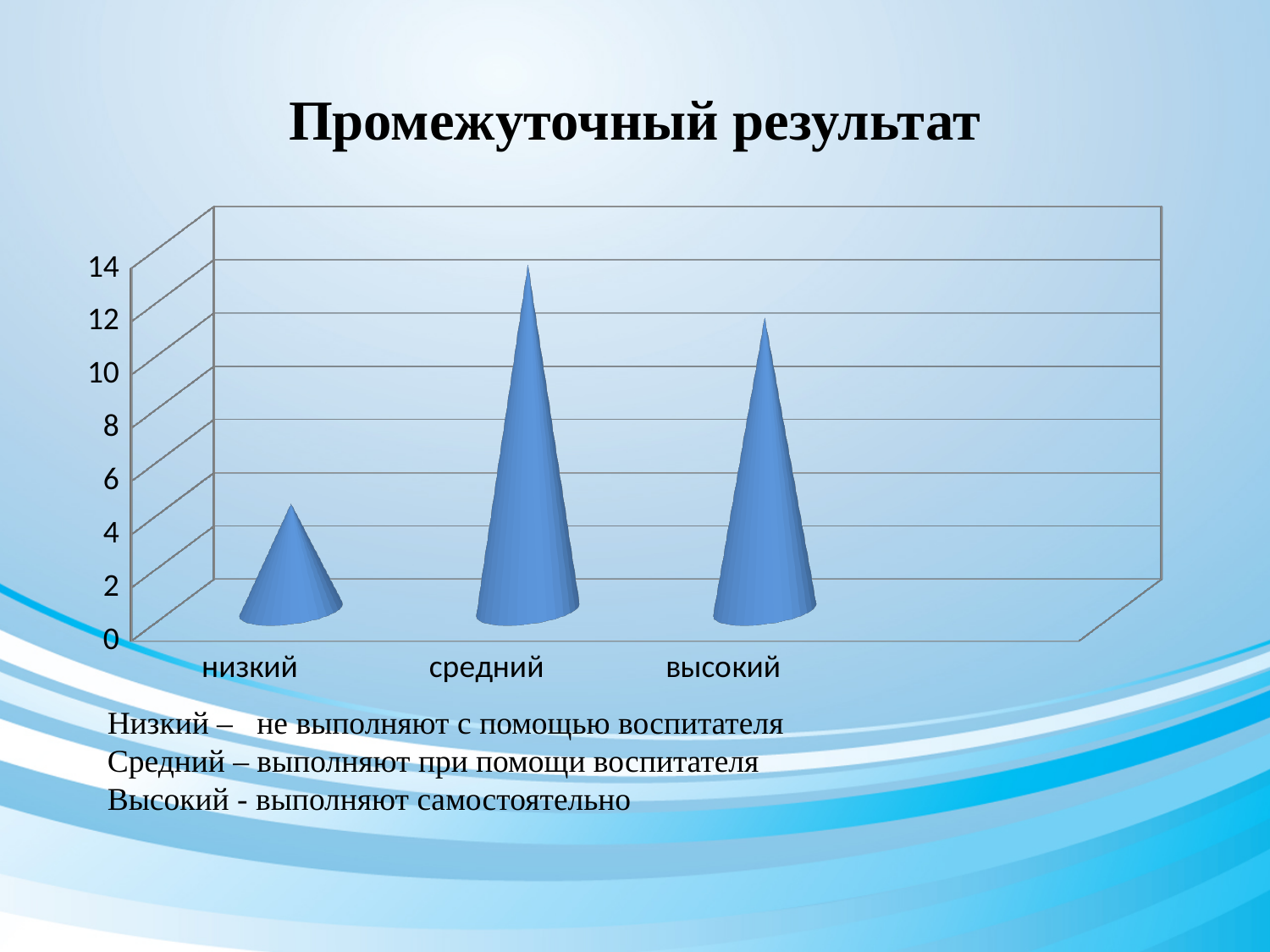
How many categories are shown on the x axis? 3 Is the value for высокий greater or less than 8? greater Which category has the lowest value? низкий Is the value for средний greater or less than 10? greater What is the title of the slide above the chart? Промежуточный результат Which is larger, the value for низкий or the value for высокий? высокий Which category has the highest value? средний Is the value for низкий greater or less than 8? less Which is larger, the value for средний or the value for высокий? средний What kind of chart is shown on the slide? bar chart What is the highest value labelled on the vertical axis? 14